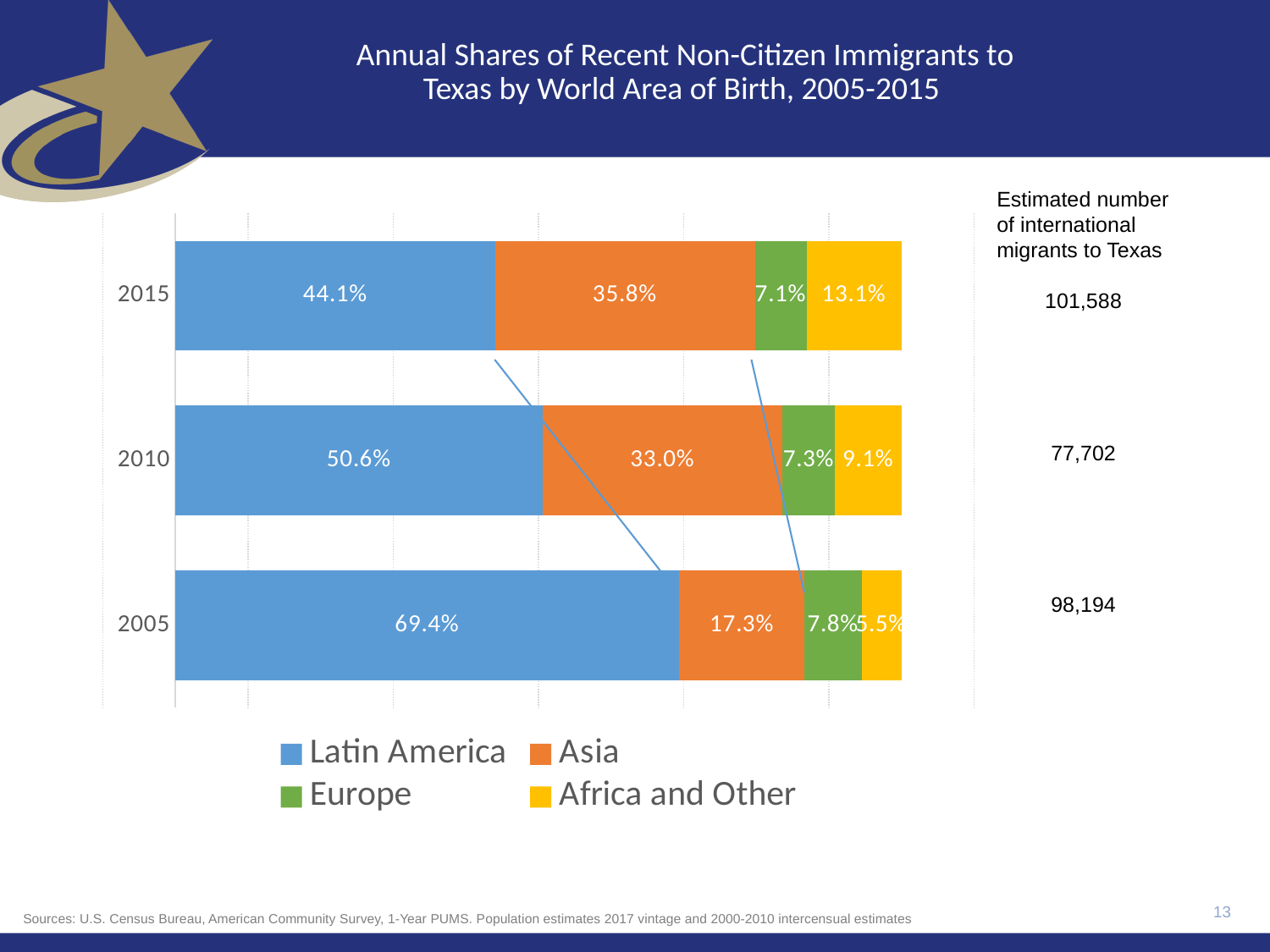
How many years are shown on the chart? 3 What share of recent non-citizen immigrants to Texas in 2010 were born in Europe? 7.3% How many series does the legend list? 4 What kind of chart is shown on the slide? Stacked bar chart Which was larger in 2010, the Asia share or the Africa and Other share? Asia By how many percentage points did the Latin America share fall from 2005 to 2015? 25.3 percentage points What share of recent non-citizen immigrants to Texas in 2005 were born in Asia? 17.3% What is the estimated number of international migrants to Texas shown for 2010? 77,702 What share of recent non-citizen immigrants to Texas in 2015 were born in Latin America? 44.1% In which year was the Asia share the lowest? 2005 What share of recent non-citizen immigrants to Texas in 2015 were born in Africa and Other? 13.1% In which year was the Latin America share the highest? 2005